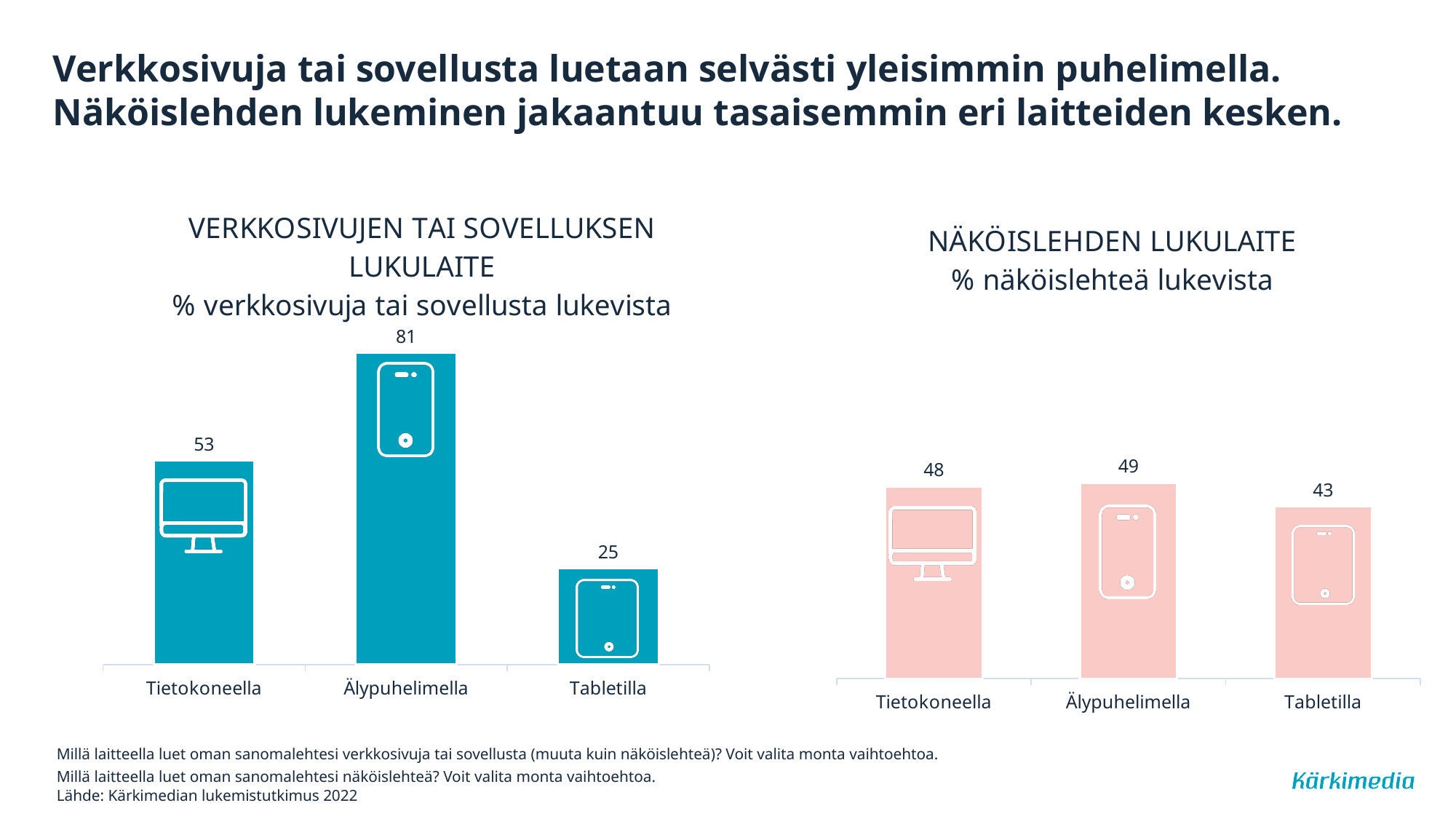
In the left chart (VERKKOSIVUJEN TAI SOVELLUKSEN LUKULAITE), what is the difference between the values for Älypuhelimella and Tietokoneella? 28 In the left chart (VERKKOSIVUJEN TAI SOVELLUKSEN LUKULAITE), what is the value for Älypuhelimella? 81 Is the value for Tietokoneella larger in the left chart (VERKKOSIVUJEN TAI SOVELLUKSEN LUKULAITE) or in the right chart (NÄKÖISLEHDEN LUKULAITE)? Left chart What kind of chart is the left chart (VERKKOSIVUJEN TAI SOVELLUKSEN LUKULAITE)? Bar chart In the right chart (NÄKÖISLEHDEN LUKULAITE), what is the value for Tietokoneella? 48 How many categories does the right chart (NÄKÖISLEHDEN LUKULAITE) show? 3 In the left chart (VERKKOSIVUJEN TAI SOVELLUKSEN LUKULAITE), which category has the lowest value? Tabletilla In the right chart (NÄKÖISLEHDEN LUKULAITE), what is the value for Tabletilla? 43 In the left chart (VERKKOSIVUJEN TAI SOVELLUKSEN LUKULAITE), what is the value for Tabletilla? 25 In the right chart (NÄKÖISLEHDEN LUKULAITE), what is the difference between the values for Älypuhelimella and Tabletilla? 6 In the left chart (VERKKOSIVUJEN TAI SOVELLUKSEN LUKULAITE), which category has the highest value? Älypuhelimella In the right chart (NÄKÖISLEHDEN LUKULAITE), which category has the lowest value? Tabletilla